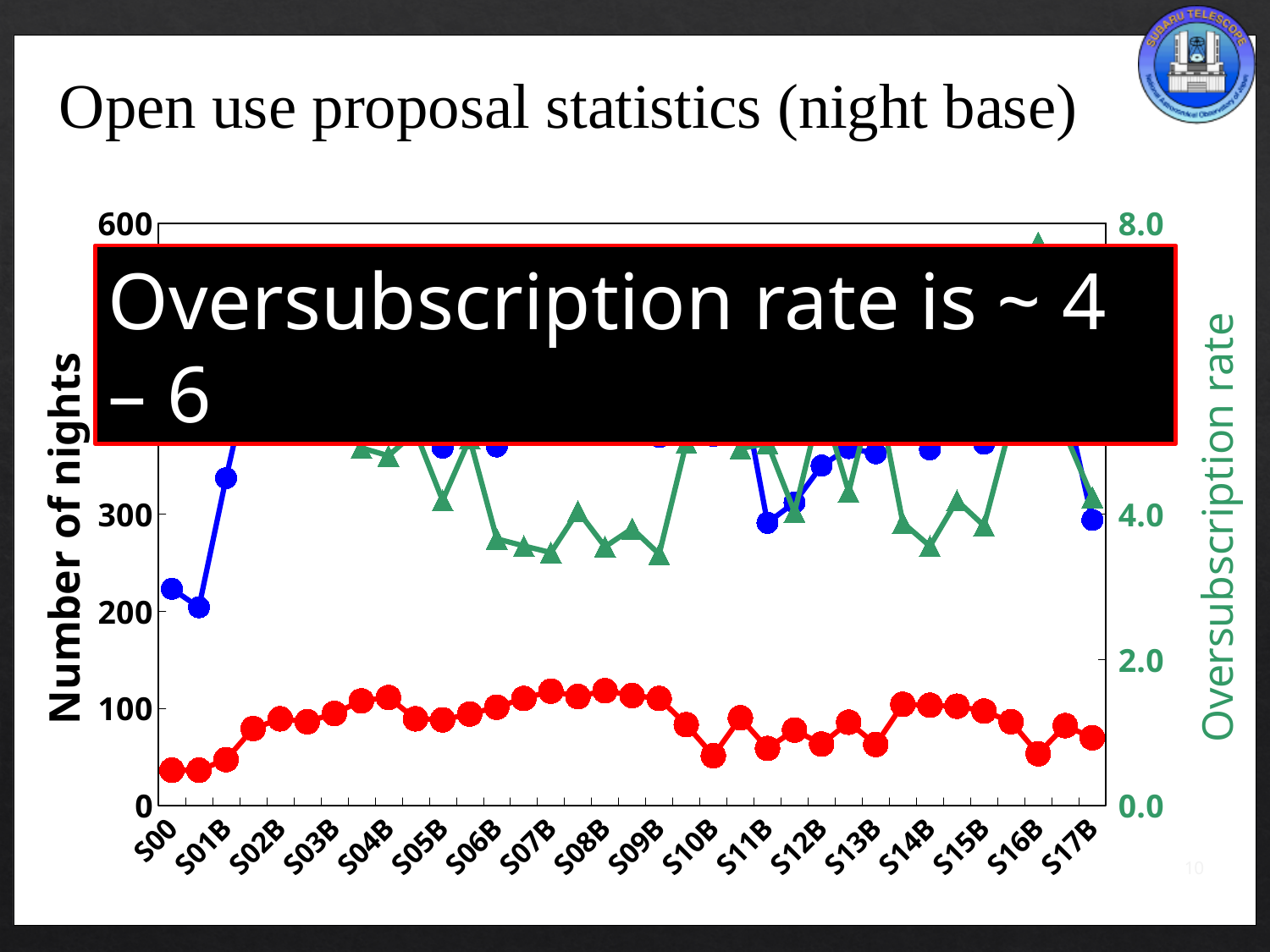
Is the value of the red series at S07B greater or less than 100? greater Which is larger for the red series: the value at S07B or the value at S10B? S07B Is the value of the red series at S00 greater or less than 100? less What kind of chart is shown on the slide? line chart Does the red series rise or fall from S00 to S04B? rise Which semester has the highest value in the green series (oversubscription rate)? S16B Is the value of the blue series at S00 greater or less than 200? greater What is the title of the right vertical axis? Oversubscription rate What is the title of the left vertical axis? Number of nights How many semester labels are shown on the x axis? 18